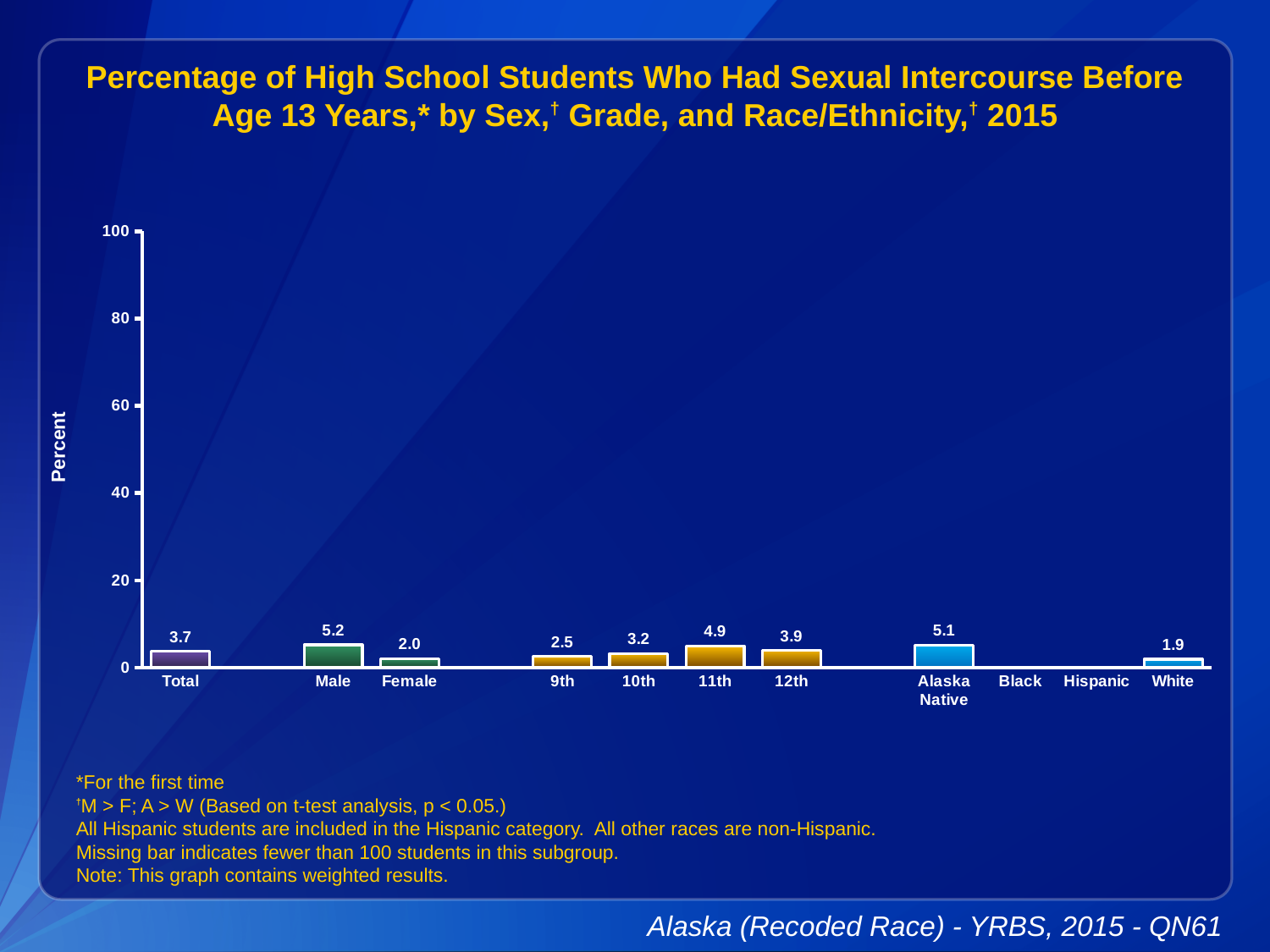
Which is larger, the value for 12th grade or the value for 10th grade? 12th Among the grade categories (9th, 10th, 11th, 12th), which has the lowest value? 9th Among the grade categories (9th, 10th, 11th, 12th), which has the highest value? 11th Is the value for Total greater or less than 20? less What is the value for 11th grade? 4.9 Which race/ethnicity categories have no bar shown? Black and Hispanic How many categories are labeled on the x axis? 11 What percentage is shown for Male students? 5.2 What is the difference between the Male and Female values? 3.2 What is the value for Total? 3.7 What is the value for Alaska Native students? 5.1 What kind of chart is shown on the slide? bar chart